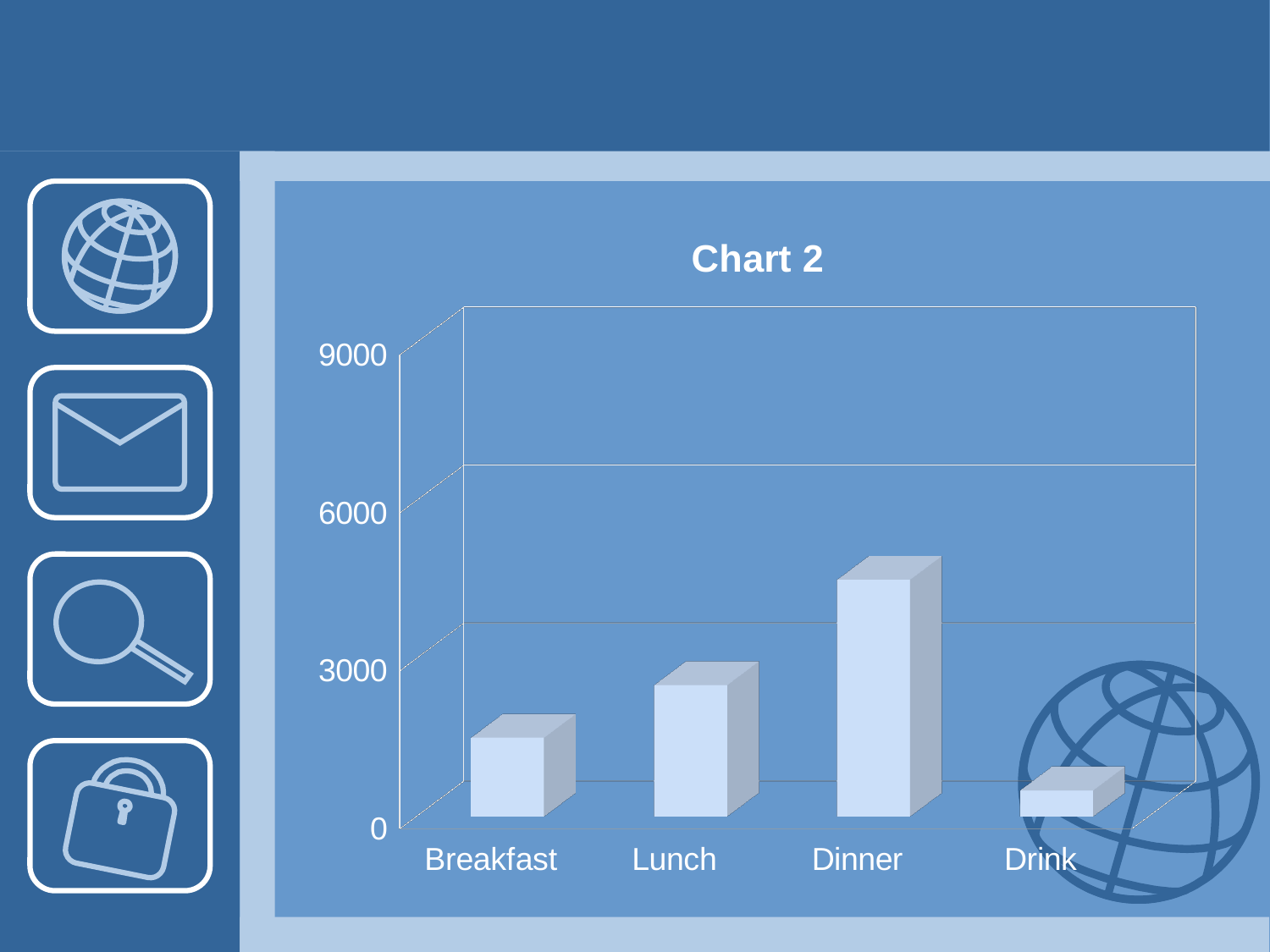
Do the values rise or fall from Breakfast to Dinner along the x axis? rise Is the value for Dinner greater or less than 6000? less Which is larger, the value for Breakfast or the value for Drink? Breakfast Which is larger, the value for Lunch or the value for Breakfast? Lunch Is the value for Dinner greater or less than 3000? greater Which category has the lowest value in the chart? Drink Is the value for Drink greater or less than 3000? less What kind of chart is shown on the slide? bar chart Which category has the highest value in the chart? Dinner How many categories are shown on the x axis of the chart? 4 What is the title of the chart? Chart 2